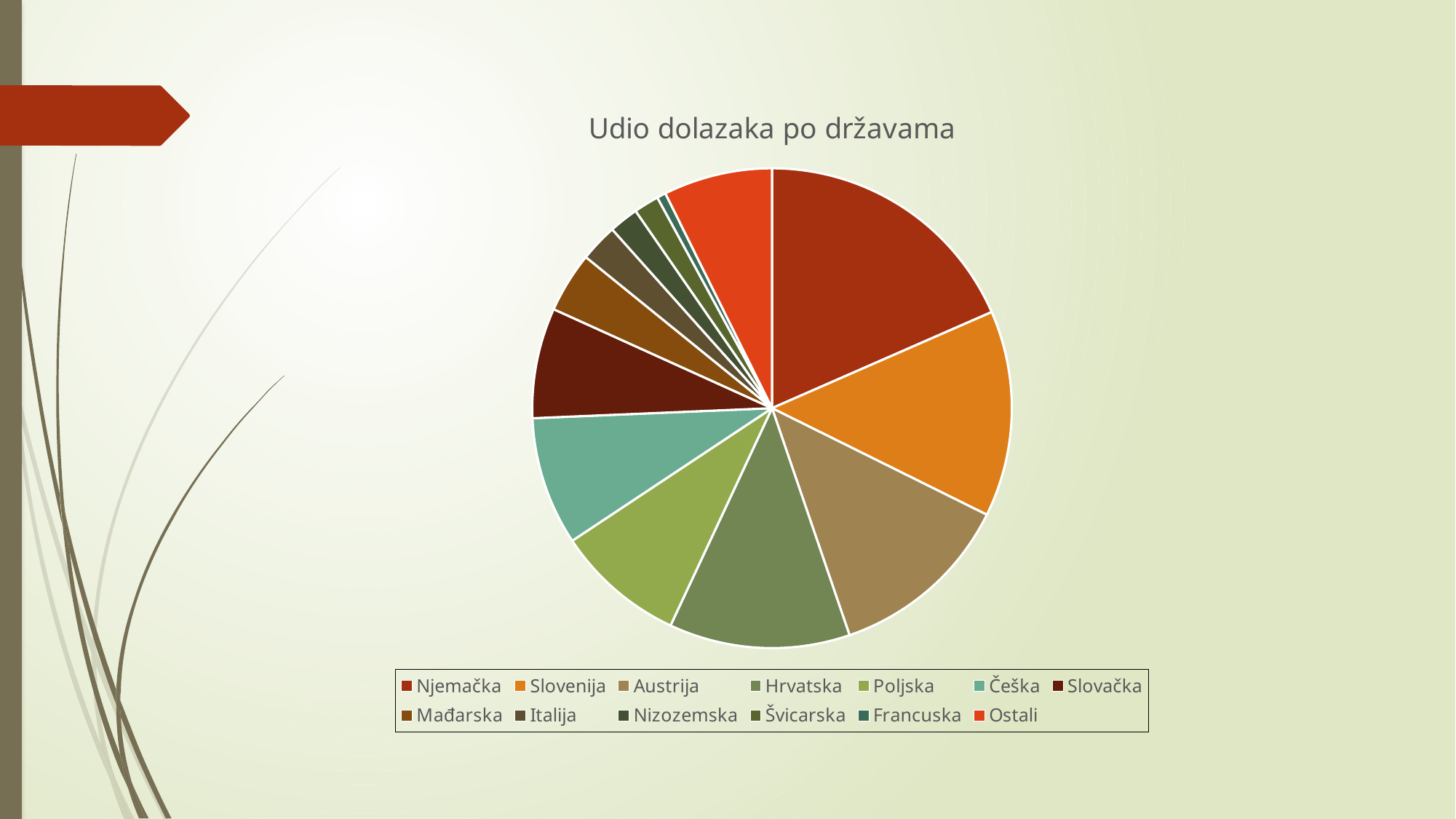
Which slice is larger, Njemačka or Slovenija? Njemačka What kind of chart is shown on the slide? pie chart Which slice is larger, Italija or Francuska? Italija Which slice is larger, Hrvatska or Nizozemska? Hrvatska How many categories (countries/groups) does the pie chart have? 13 Which legend entry is listed last in the legend? Ostali Which category has the smallest slice of the pie? Francuska What is the title of the chart? Udio dolazaka po državama Which category has the largest slice of the pie? Njemačka